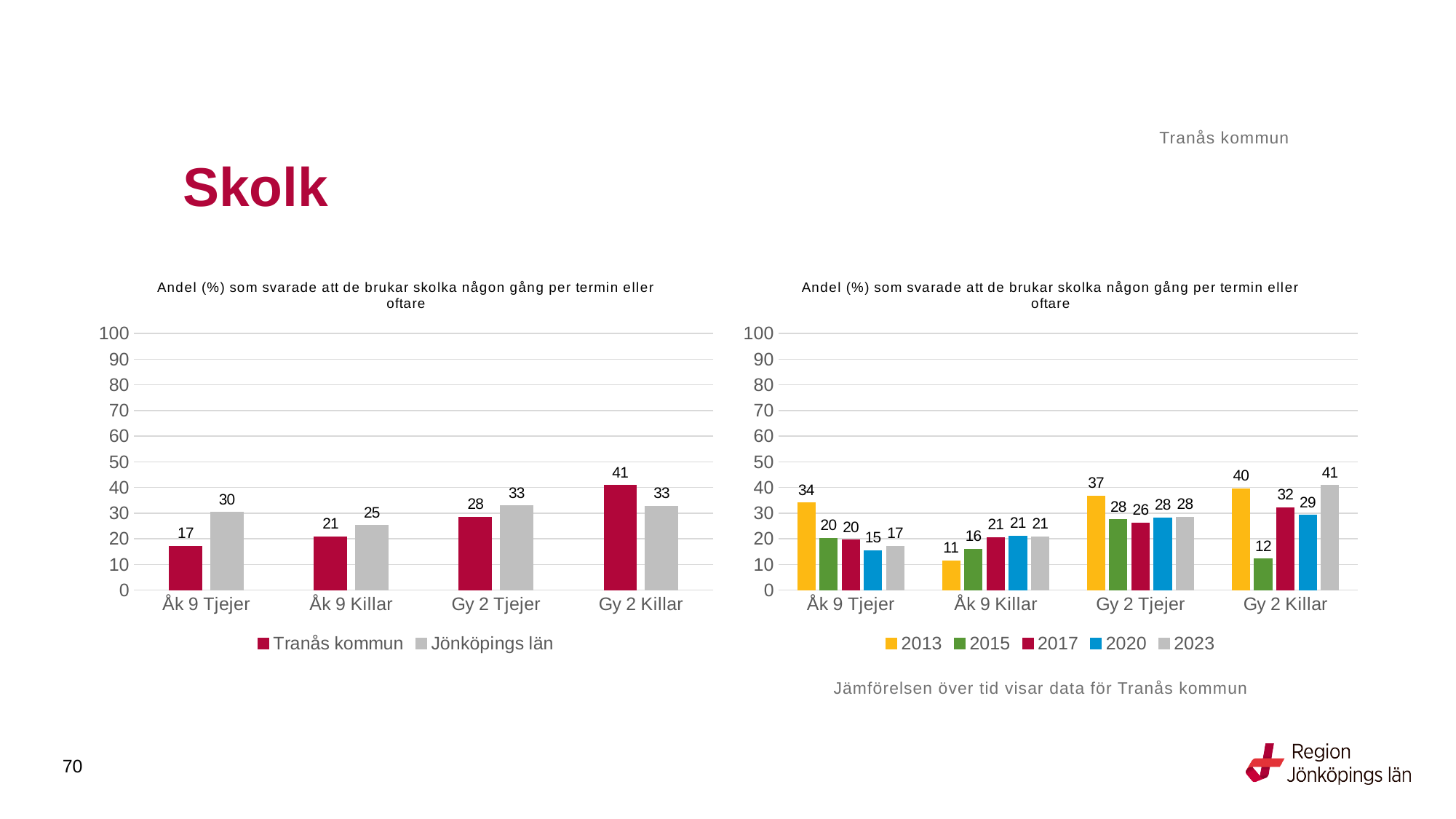
In the right chart, which year has the lowest value for Åk 9 Killar? 2013 In the right chart, what is the value for 2013 for Gy 2 Tjejer? 37 How many series does the legend of the right chart list? 5 In the right chart, what is the difference between 2013 and 2023 for Åk 9 Tjejer? 17 How many series does the legend of the left chart list? 2 In the right chart, what is the value for 2015 for Gy 2 Killar? 12 In the left chart, what is the difference between Jönköpings län and Tranås kommun for Åk 9 Tjejer? 13 In the left chart, which category has the highest value for Tranås kommun? Gy 2 Killar In the left chart, which is larger for Gy 2 Killar: Tranås kommun or Jönköpings län? Tranås kommun In the left chart, what is the value for Jönköpings län for Åk 9 Tjejer? 30 What kind of chart is the right chart? Bar chart In the left chart, what is the value for Tranås kommun for Gy 2 Killar? 41